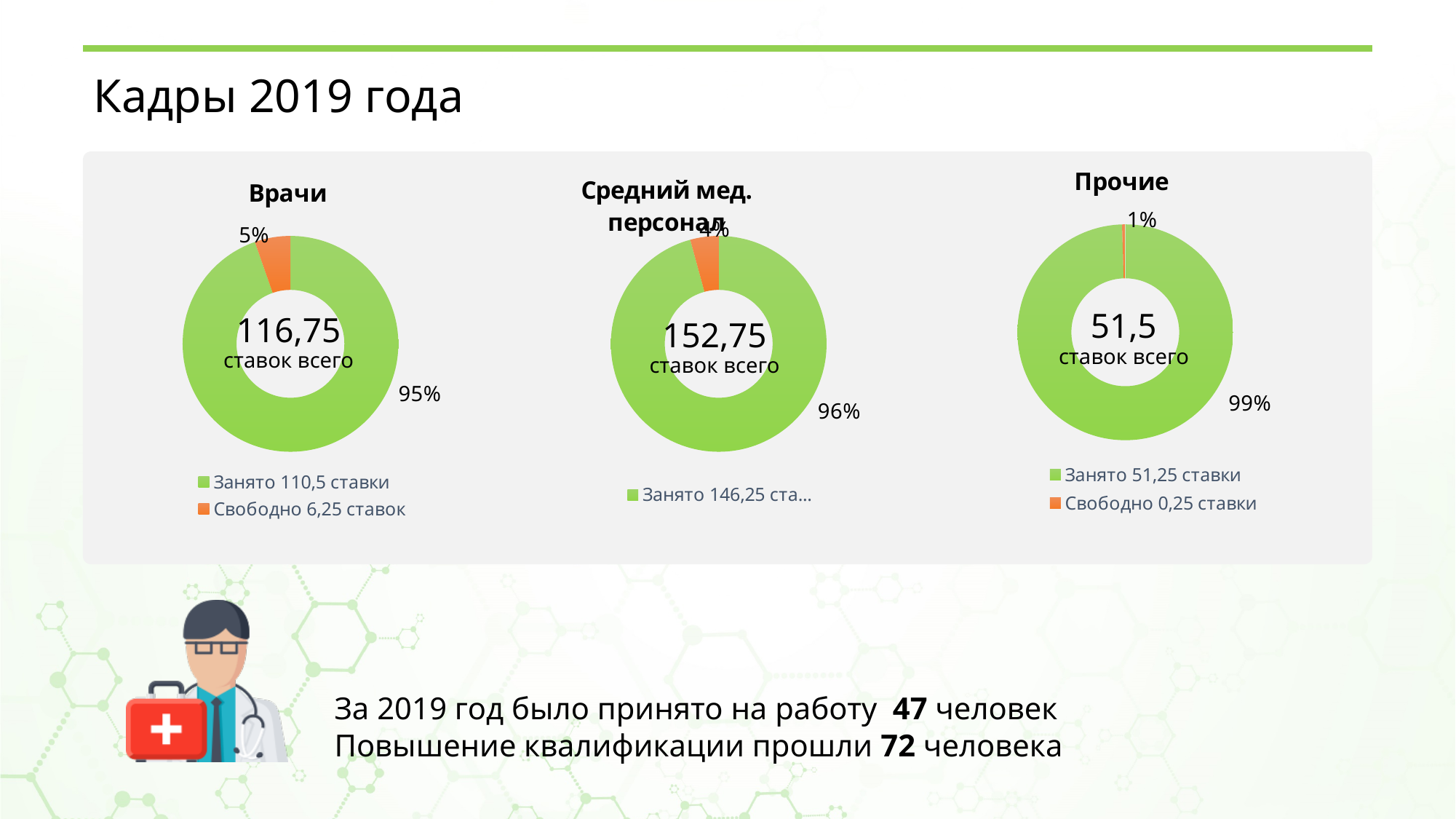
In the "Прочие" chart, what share of the total is free (Свободно)? 1% What is the total number of positions (ставок всего) shown in the centre of the "Прочие" chart? 51,5 Which chart has the larger free (Свободно) share: "Врачи" or "Прочие"? Врачи In the "Врачи" chart, what share of the total is free (Свободно)? 5% In the "Средний мед. персонал" chart, what share of the total is occupied (Занято)? 96% According to the legend of the "Врачи" chart, how many positions are free (Свободно)? 6,25 ставок How many entries does the legend of the "Прочие" chart list? 2 How many slices does the "Врачи" chart have? 2 What kind of chart is used for "Врачи"? Donut (pie) chart According to the legend of the "Прочие" chart, how many positions are occupied (Занято)? 51,25 ставки What is the total number of positions (ставок всего) shown in the centre of the "Средний мед. персонал" chart? 152,75